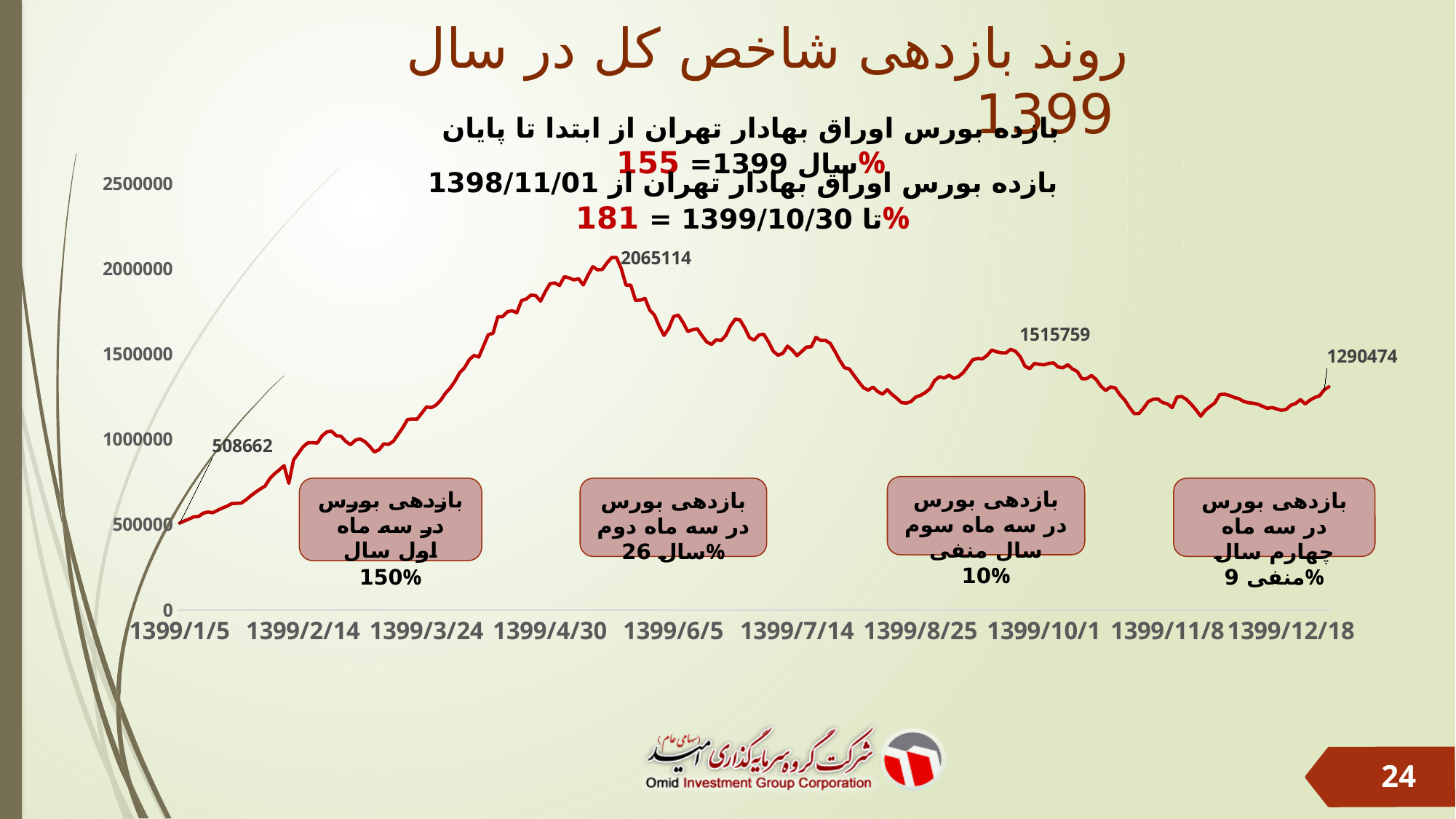
What is the difference between the peak labelled value (2065114) and the starting labelled value (508662)? 1556452 Is the value of the line at 1399/11/8 greater or less than 1500000? less Does the line rise or fall between 1399/1/5 and 1399/4/30? rise Which is larger, the labelled value 1515759 or the final labelled value 1290474? 1515759 What is the value of the labelled point near 1399/10/1? 1515759 How many date labels are shown on the x axis? 10 What is the value of the first labelled point on the line, at the start of the year? 508662 What is the value of the highest labelled point on the line? 2065114 What is the value of the last labelled point on the line, at the end of the year? 1290474 What kind of chart is shown on the slide? line chart According to the text box, what was the stock exchange return in the first three months of the year? 150% What is the difference between the peak labelled value (2065114) and the final labelled value (1290474)? 774640